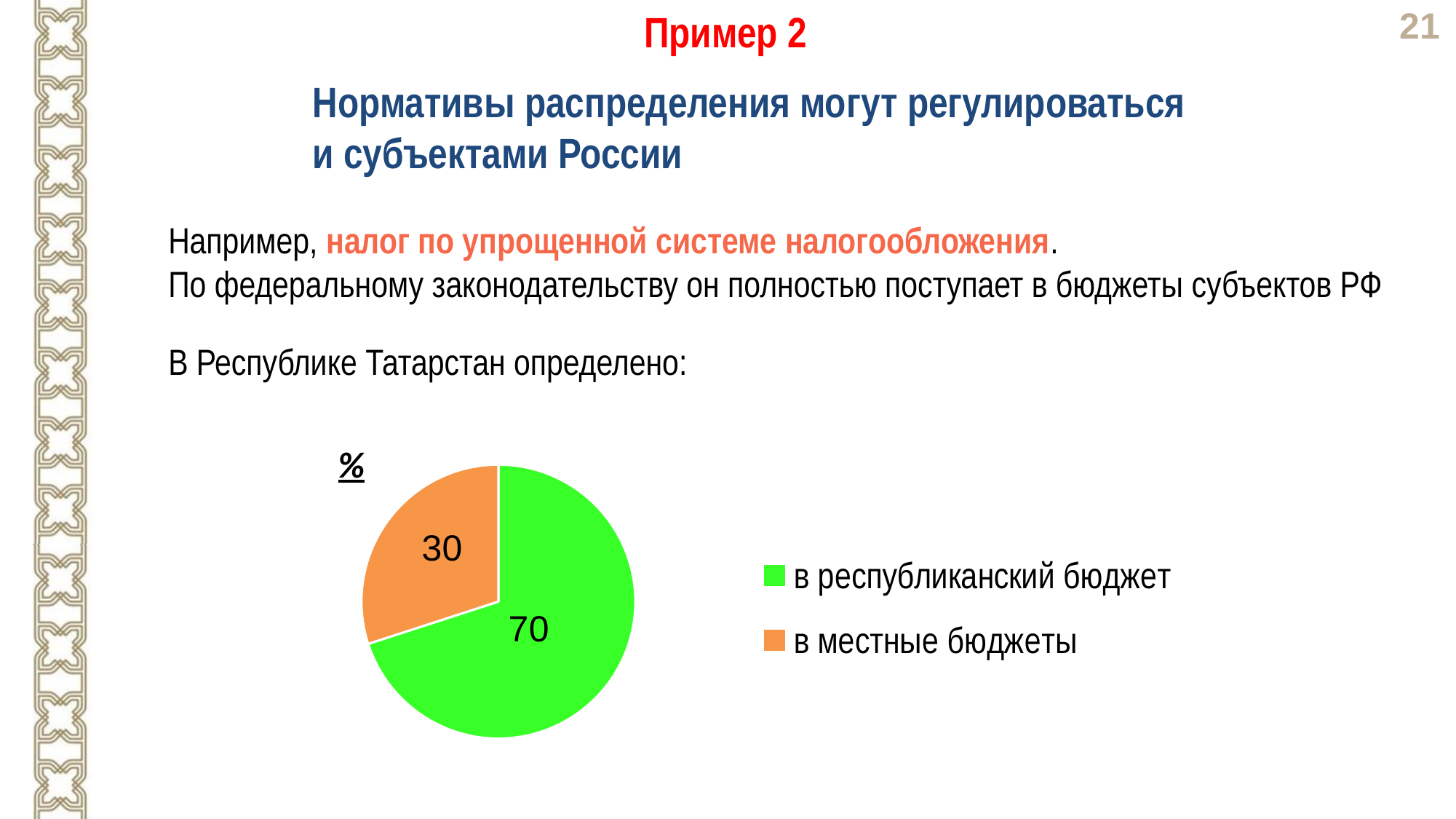
What kind of chart is shown on the slide? pie chart What share of the pie does "в местные бюджеты" represent? 30% Which is larger: the value for "в республиканский бюджет" or for "в местные бюджеты"? в республиканский бюджет How many slices does the pie chart have? 2 Which category has the largest slice? в республиканский бюджет What unit label is shown next to the pie chart? % What colour is the slice for "в республиканский бюджет"? green What is the value for "в местные бюджеты"? 30 Which category has the smallest slice? в местные бюджеты How many entries does the legend list? 2 What is the value for "в республиканский бюджет"? 70 What is the difference between the values for "в республиканский бюджет" and "в местные бюджеты"? 40